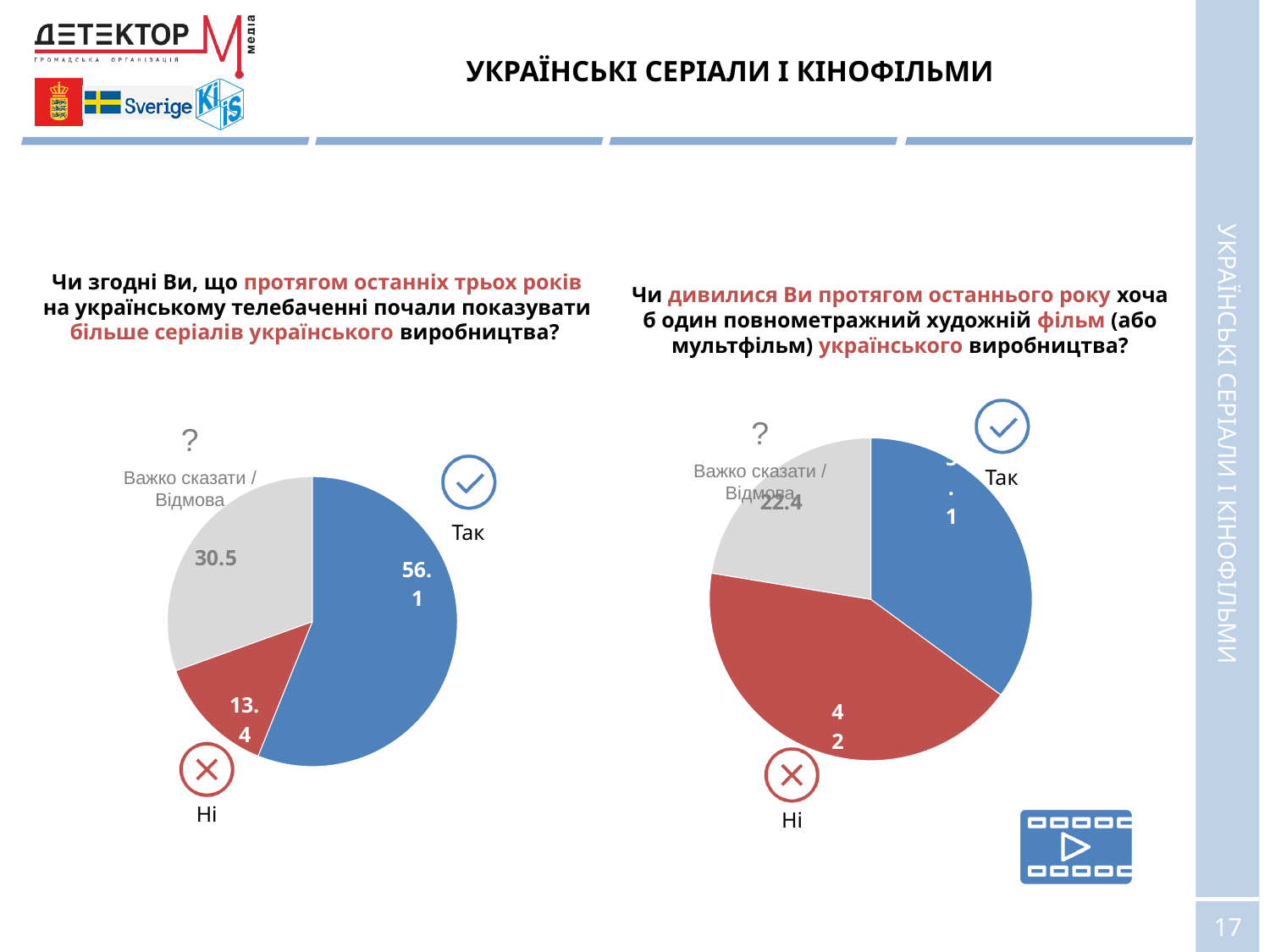
In the left pie chart (about more Ukrainian-made series on TV), which answer has the largest share? Так In the left pie chart (about more Ukrainian-made series on TV), which answer has the smallest share? Ні In the right pie chart (about watching a Ukrainian-made feature film), what value is shown for "Важко сказати / Відмова"? 22.4 In the right pie chart (about watching a Ukrainian-made feature film), which answer has the smallest share? Важко сказати / Відмова In the right pie chart (about watching a Ukrainian-made feature film), which is larger, the "Так" slice or the "Ні" slice? Ні What type of chart is used on this slide? Pie chart In the left pie chart (about more Ukrainian-made series on TV), what value is shown for "Ні"? 13.4 In the left pie chart (about more Ukrainian-made series on TV), what percentage answered "Так"? 56.1 In the left pie chart (about more Ukrainian-made series on TV), what is the difference between the "Так" and "Ні" values? 42.7 In the left pie chart (about more Ukrainian-made series on TV), how many slices does the pie have? 3 In the left pie chart (about more Ukrainian-made series on TV), what value is shown for "Важко сказати / Відмова"? 30.5 What colour is the "Ні" slice in both pie charts? Red